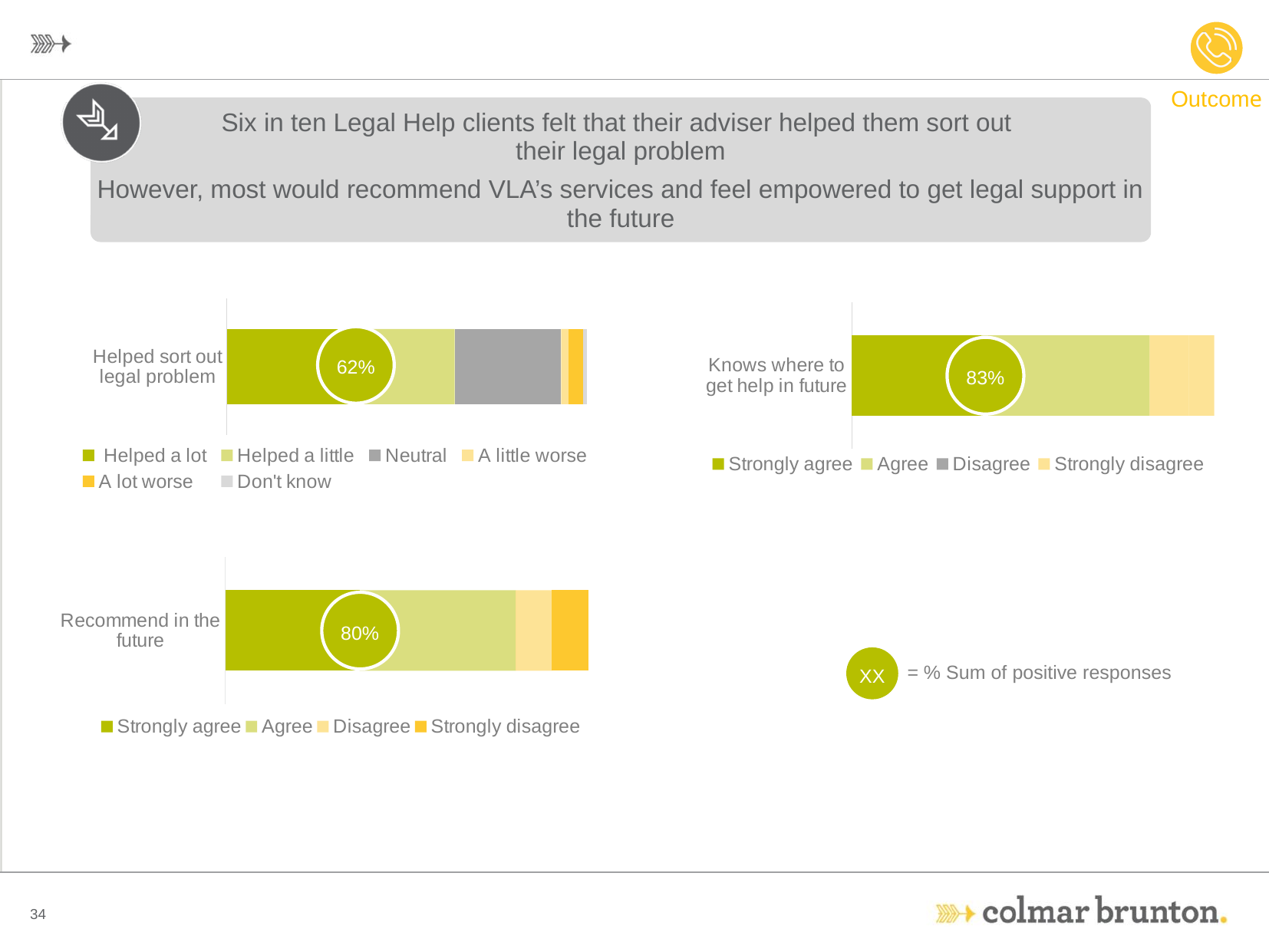
How many entries does the legend of the 'Helped sort out legal problem' chart list? 6 Across the three charts, which measure has the lowest sum of positive responses? Helped sort out legal problem What is the difference between the positive response sums for 'Knows where to get help in future' and 'Recommend in the future'? 3 percentage points Across the three charts, which measure has the highest sum of positive responses? Knows where to get help in future In the 'Recommend in the future' chart, what is the sum of positive responses shown in the circle? 80% According to the key on the slide, what does the number in the circle on each bar represent? % Sum of positive responses What kind of chart is used for 'Recommend in the future'? Stacked bar chart What is the difference between the positive response sums for 'Knows where to get help in future' and 'Helped sort out legal problem'? 21 percentage points In the 'Helped sort out legal problem' chart, what is the sum of positive responses shown in the circle? 62% How many entries does the legend of the 'Knows where to get help in future' chart list? 4 Which has a larger sum of positive responses: 'Recommend in the future' or 'Helped sort out legal problem'? Recommend in the future In the 'Knows where to get help in future' chart, what is the sum of positive responses shown in the circle? 83%